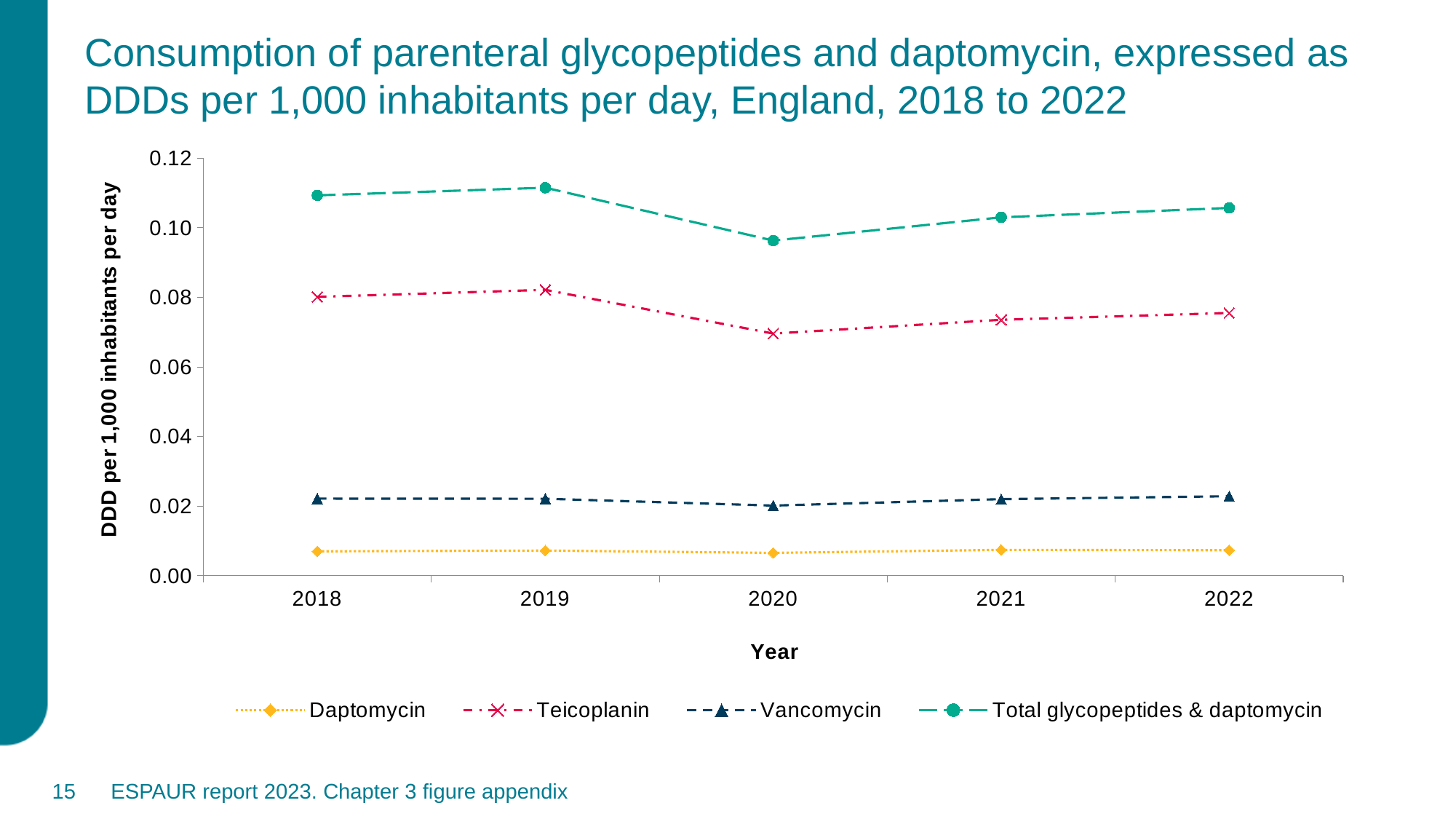
In which year is the value for Total glycopeptides & daptomycin lowest? 2020 Does the value for Total glycopeptides & daptomycin rise or fall from 2020 to 2022? rise How many series does the legend list? 4 Which series has the highest value in 2022? Total glycopeptides & daptomycin What is the title of the y axis? DDD per 1,000 inhabitants per day What kind of chart is shown on the slide? line chart In which year is the value for Teicoplanin lowest? 2020 Is the value for Daptomycin in 2018 greater or less than 0.02? less Is the value for Total glycopeptides & daptomycin in 2020 greater or less than 0.10? less How many years are plotted along the x axis? 5 Which is larger in 2022, the value for Vancomycin or the value for Daptomycin? Vancomycin Is the value for Teicoplanin in 2022 greater or less than 0.08? less